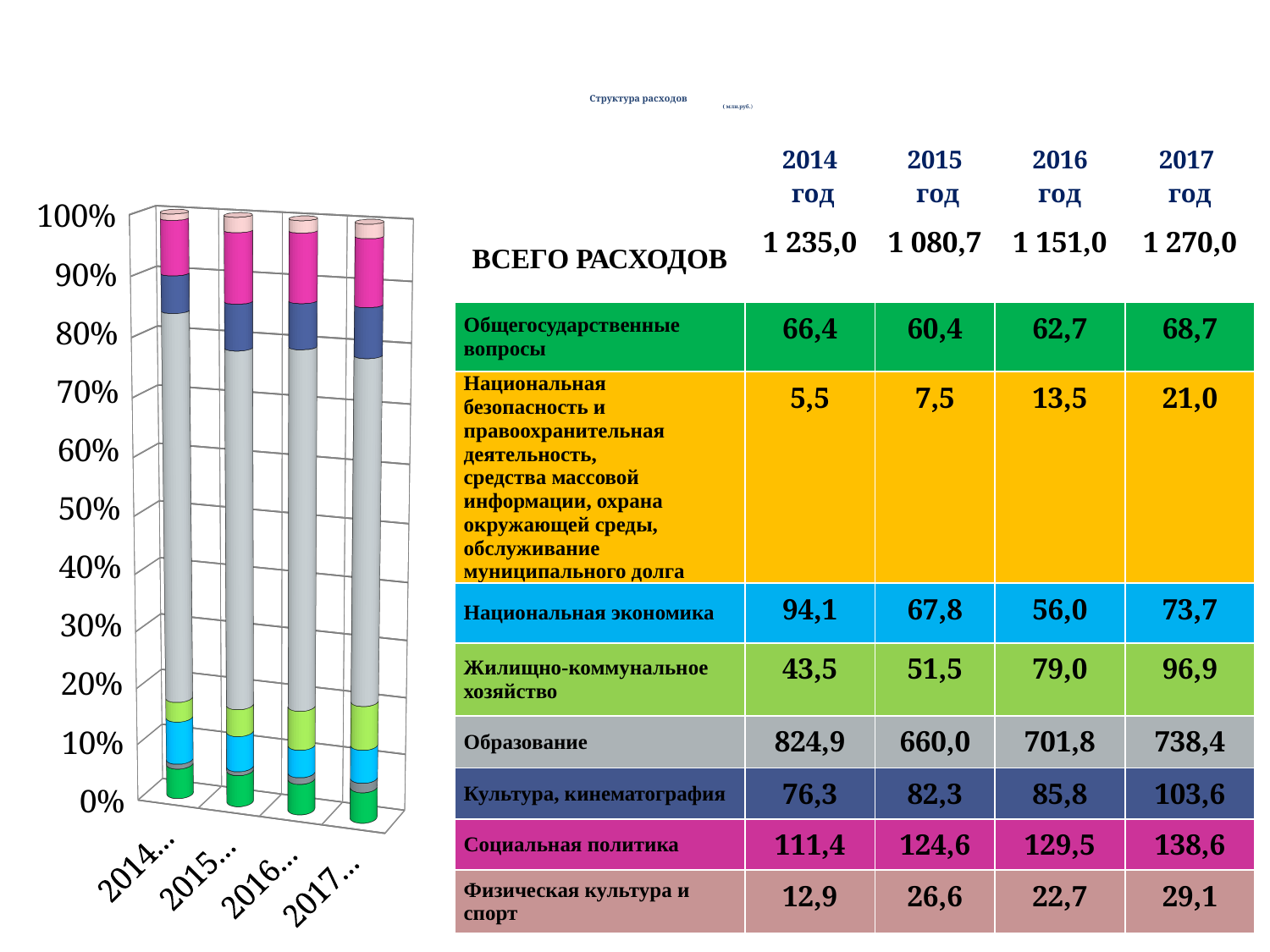
In the chart, does the large grey segment occupy more or less than half of the 2016 bar? more Which segment colour occupies the largest share of every bar in the chart? grey In the chart, is the top of the large grey segment for the 2014 bar greater or less than 80%? greater What kind of chart is shown on the left of the slide? stacked bar chart Which year's bar is the first (leftmost) category on the chart's horizontal axis? 2014 What is the step between consecutive tick labels on the vertical axis of the chart? 10% What is the highest value shown on the vertical axis of the chart? 100% In the chart, is the top of the light-green segment for the 2014 bar greater or less than 30%? less How many bars (years) does the chart on the left show? 4